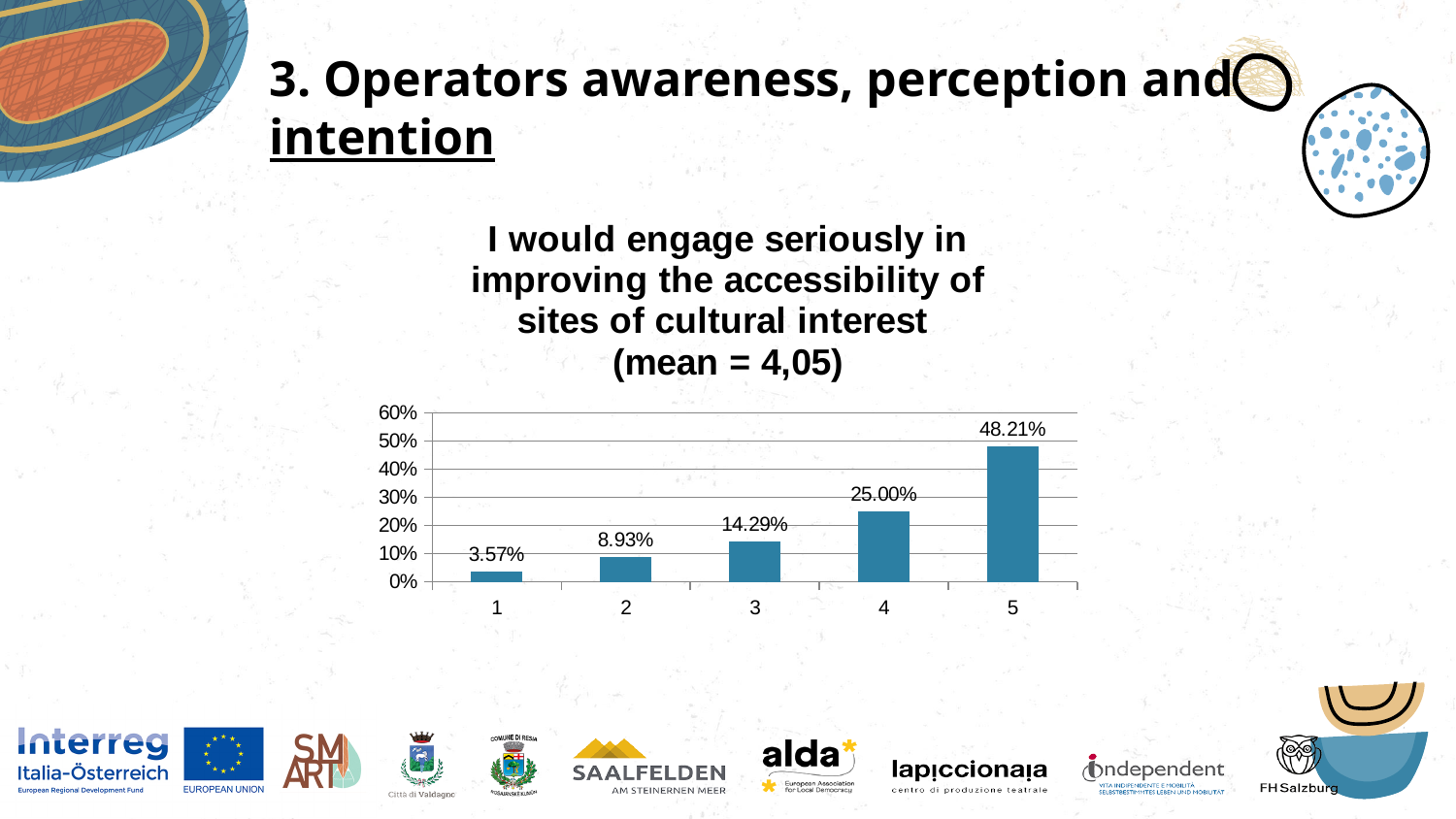
Is the value for category 4 greater or less than 20%? greater What is the value for category 5? 48.21% What is the value for category 3? 14.29% Do the values rise or fall from category 1 to category 5? rise Which category has the lowest value? 1 What is the difference between the values for category 5 and category 4? 23.21% What is the value for category 1? 3.57% How many categories are shown on the x axis? 5 What mean value is stated in the chart title? 4,05 Which category has the highest value? 5 Which is larger, the value for category 2 or the value for category 3? 3 What kind of chart is shown? bar chart